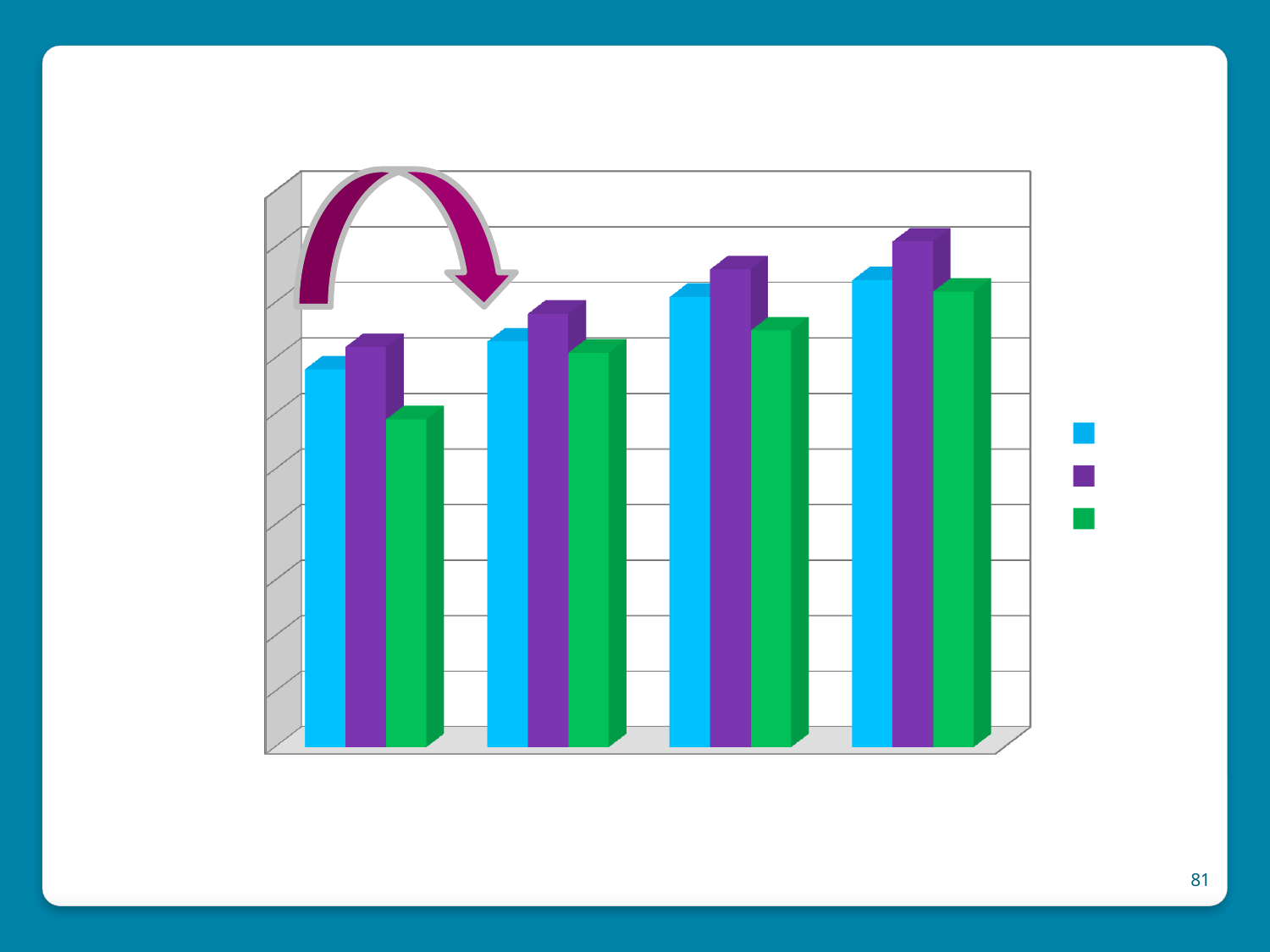
Within each group of bars, which colour of bar is the tallest? purple What kind of chart is shown on the slide? bar chart Do the values of the green series rise or fall from left to right along the x axis? rise How many series does the legend list? 3 Which group of bars, counted from the left, contains the tallest bar on the chart? the fourth (rightmost) group Do the values of the blue series rise or fall from left to right along the x axis? rise In the leftmost group of bars, which is larger: the blue bar or the green bar? blue What colours are the three series shown in the legend, from top to bottom? blue, purple, green Do the values of the purple series rise or fall from left to right along the x axis? rise How many groups of bars (categories) are plotted along the x axis? 4 Which group of bars, counted from the left, contains the shortest bar on the chart? the first (leftmost) group